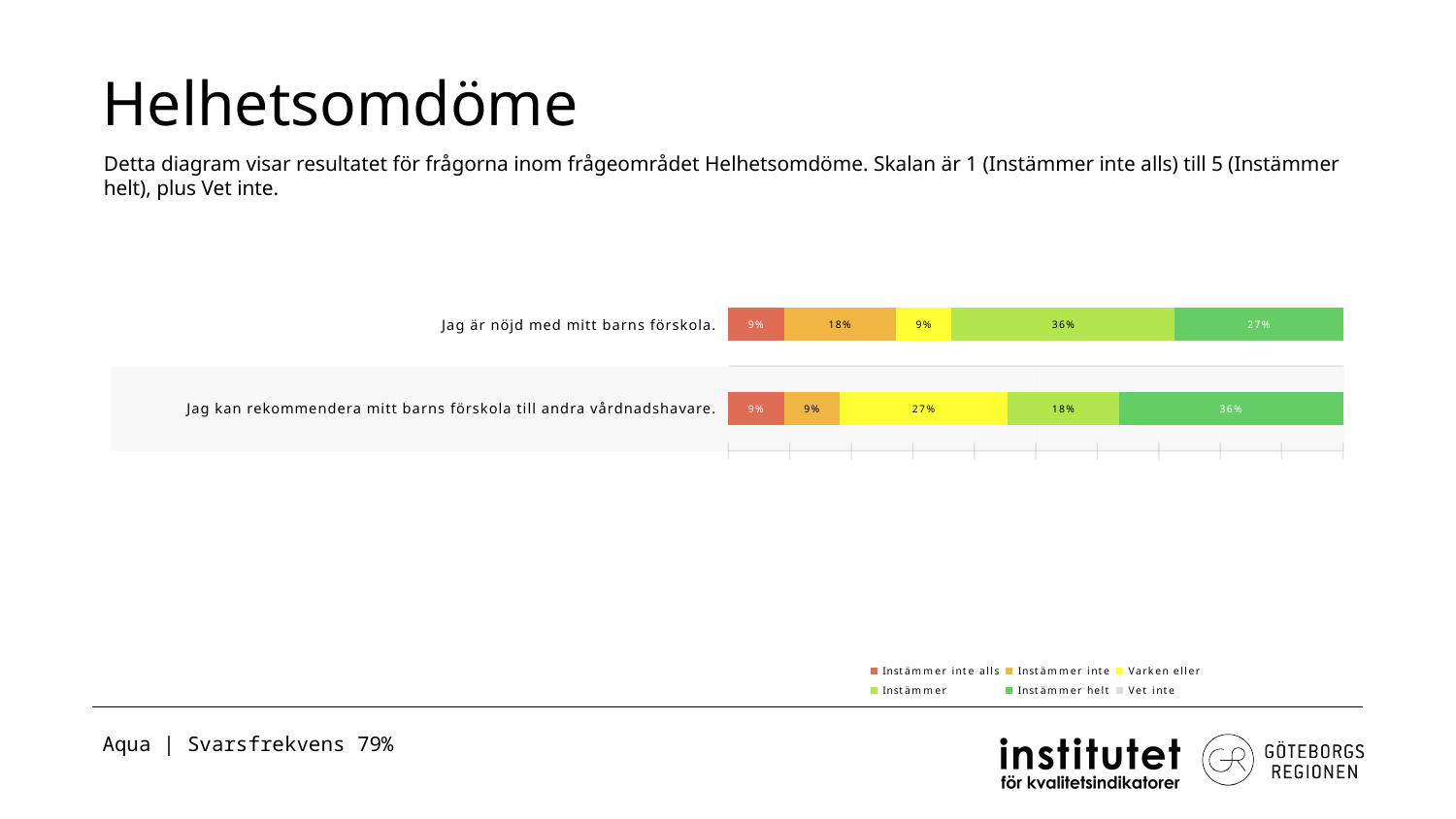
How many statements (categories) are plotted in the chart? 2 What is the 'Instämmer inte' share for 'Jag är nöjd med mitt barns förskola.'? 18% Which statement has the larger 'Varken eller' share? Jag kan rekommendera mitt barns förskola till andra vårdnadshavare. What is the 'Instämmer helt' share for 'Jag kan rekommendera mitt barns förskola till andra vårdnadshavare.'? 36% What is the 'Varken eller' share for 'Jag kan rekommendera mitt barns förskola till andra vårdnadshavare.'? 27% Which response category has the largest share for 'Jag är nöjd med mitt barns förskola.'? Instämmer What kind of chart is shown on the slide? Stacked bar chart How many series does the legend list? 6 Which response category has the largest share for 'Jag kan rekommendera mitt barns förskola till andra vårdnadshavare.'? Instämmer helt What is the difference between the 'Instämmer helt' shares of the two statements? 9% What is the total of the labelled segments for 'Jag är nöjd med mitt barns förskola.'? 99% What is the 'Instämmer' share for 'Jag är nöjd med mitt barns förskola.'? 36%